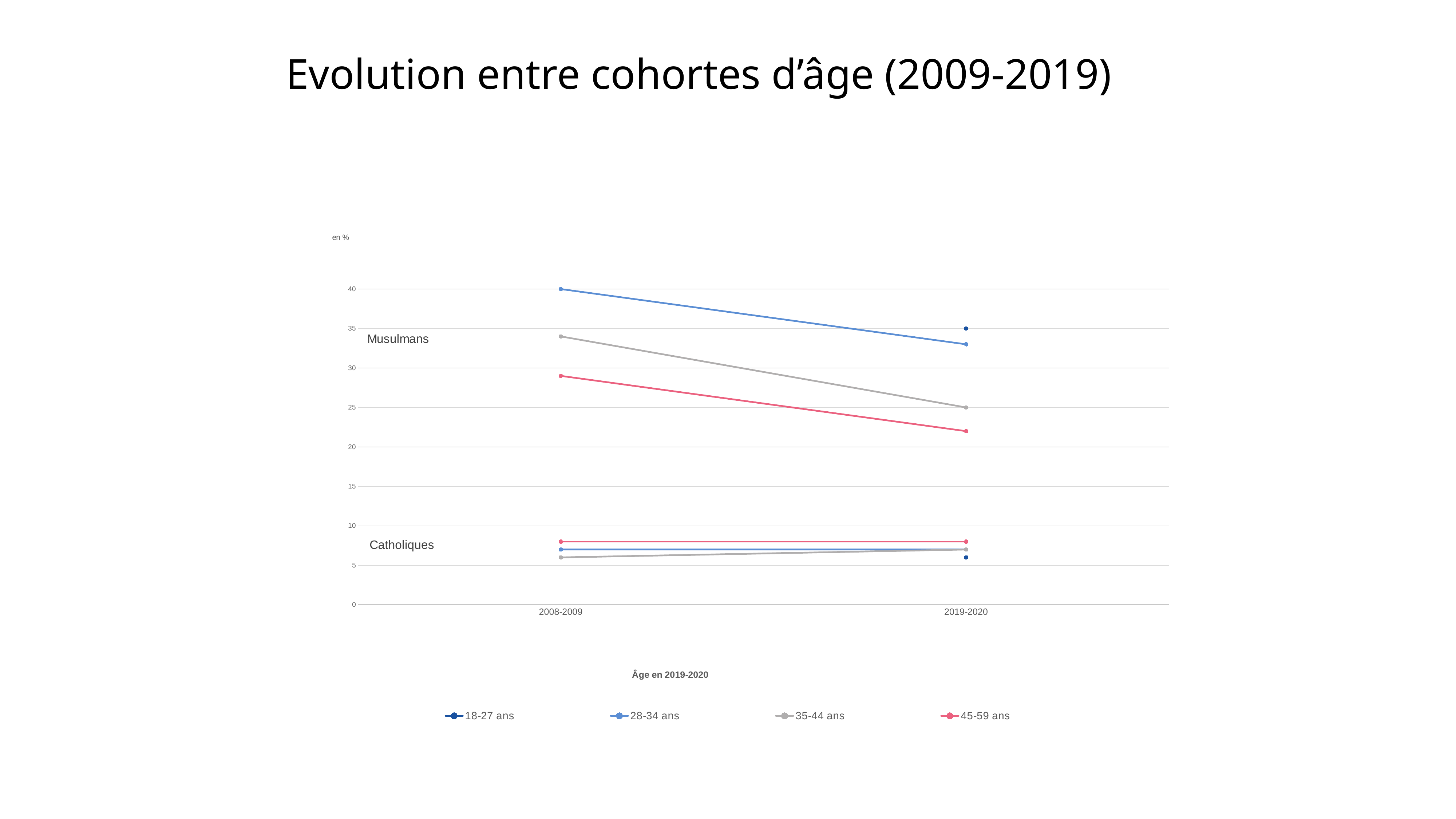
For the Musulmans group, is the value of the 45-59 ans series in 2019-2020 greater or less than 25? less For the Musulmans group, what is the value of the 28-34 ans series in 2008-2009? 40 For the Musulmans group, what is the value of the 35-44 ans series in 2019-2020? 25 How many points are on the x axis? 2 What unit label is shown on the y axis? en % For the Musulmans group, what is the value of the 18-27 ans series in 2019-2020? 35 For the Musulmans group, does the 28-34 ans line rise or fall from 2008-2009 to 2019-2020? fall For the Musulmans group in 2008-2009, which is larger: the 28-34 ans value or the 45-59 ans value? 28-34 ans For the Musulmans group in 2019-2020, what is the difference between the 18-27 ans value and the 35-44 ans value? 10 How many series does the legend list? 4 For the Musulmans group in 2008-2009, which series has the highest value? 28-34 ans What kind of chart is shown on the slide? line chart